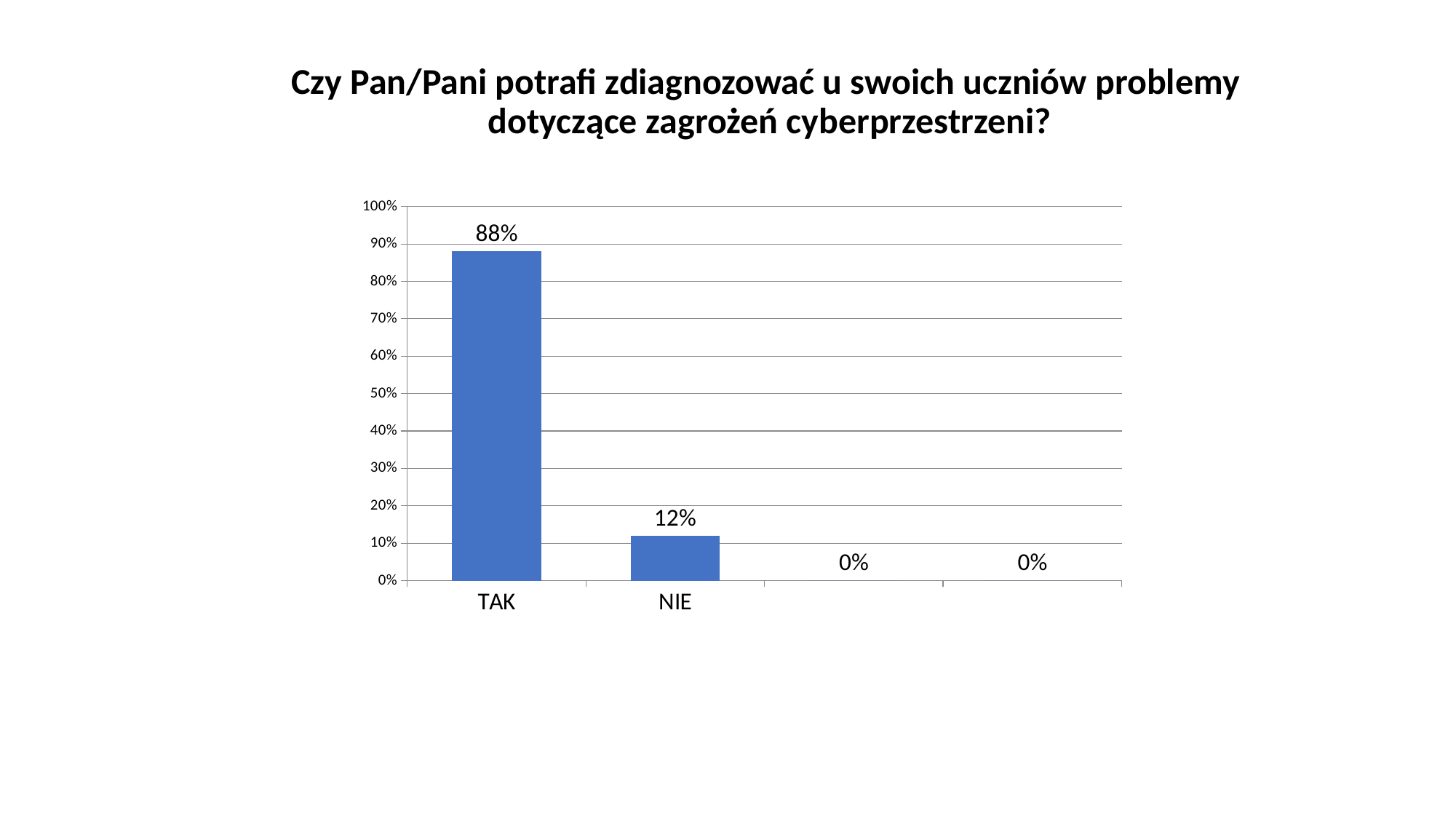
What is the difference between the values for TAK and NIE? 76% What is the highest value shown on the vertical axis? 100% Is the value for TAK greater or less than 80%? greater Is the value for NIE greater or less than 20%? less How many labelled categories are shown on the x axis? 2 How many data labels show 0%? 2 Which is larger, the value for TAK or the value for NIE? TAK Which category has the highest value? TAK What is the value for TAK? 88% What colour are the bars in the chart? blue What kind of chart is shown on the slide? bar chart What is the value for NIE? 12%